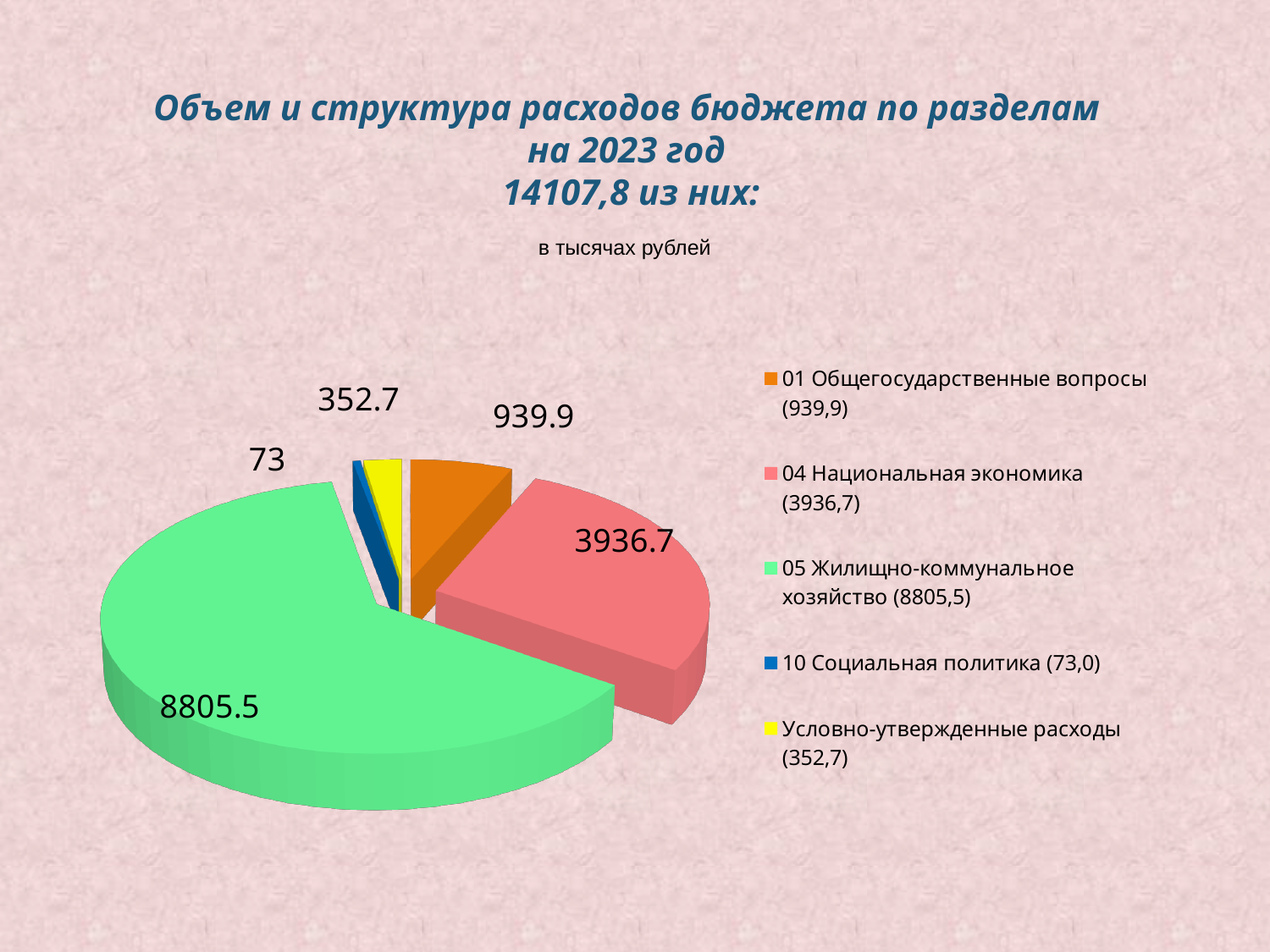
What kind of chart is shown on the slide? Pie chart How many categories does the pie chart show? 5 What is the value for 10 Социальная политика? 73 What is the value for 05 Жилищно-коммунальное хозяйство? 8805.5 Which is larger, the value for 01 Общегосударственные вопросы or for Условно-утвержденные расходы? 01 Общегосударственные вопросы What is the difference between the values for 05 Жилищно-коммунальное хозяйство and 04 Национальная экономика? 4868.8 What share of the total does 05 Жилищно-коммунальное хозяйство represent? 62.4% What colour is the slice for 04 Национальная экономика? Pink (red) What is the value for 04 Национальная экономика? 3936.7 Which category has the largest slice of the pie? 05 Жилищно-коммунальное хозяйство What is the value for Условно-утвержденные расходы? 352.7 Which category has the smallest slice of the pie? 10 Социальная политика